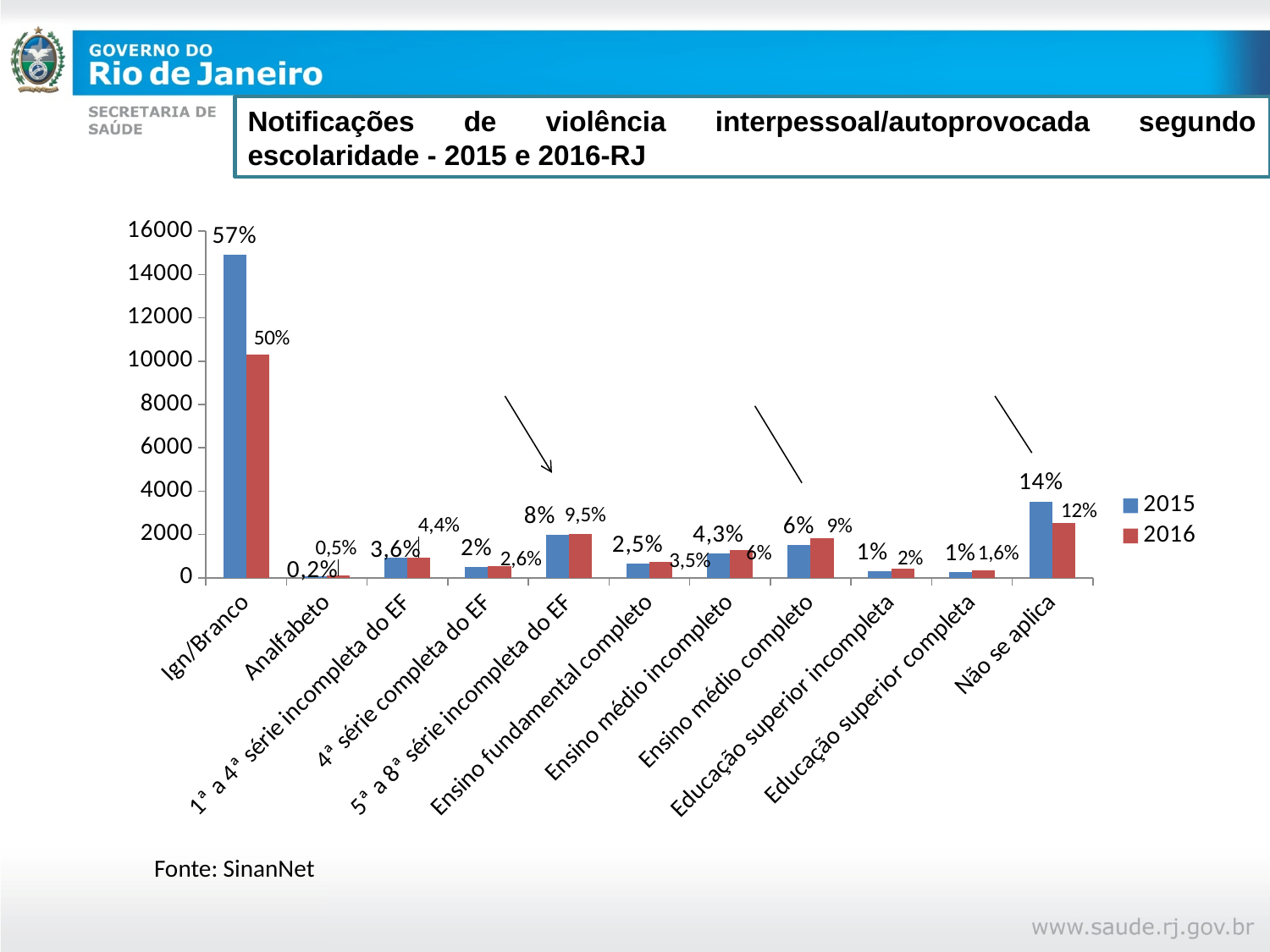
Which is larger for Ensino médio completo: the 2015 bar or the 2016 bar? 2016 How many series does the legend list? 2 Which category has the lowest number of notifications in 2015? Analfabeto Is the 2015 value for Ign/Branco greater or less than 14000? greater By how many percentage points does the Ign/Branco label for 2015 exceed the label for 2016? 7 percentage points What percentage label is shown for Não se aplica in 2016? 12% How many education-level categories are shown on the x axis? 11 Which category has the highest number of notifications in 2015? Ign/Branco What percentage label is shown for Ign/Branco in 2015? 57% What percentage label is shown for 5ª a 8ª série incompleta do EF in 2016? 9,5% What percentage label is shown for Ign/Branco in 2016? 50% What kind of chart is shown on the slide? Bar chart